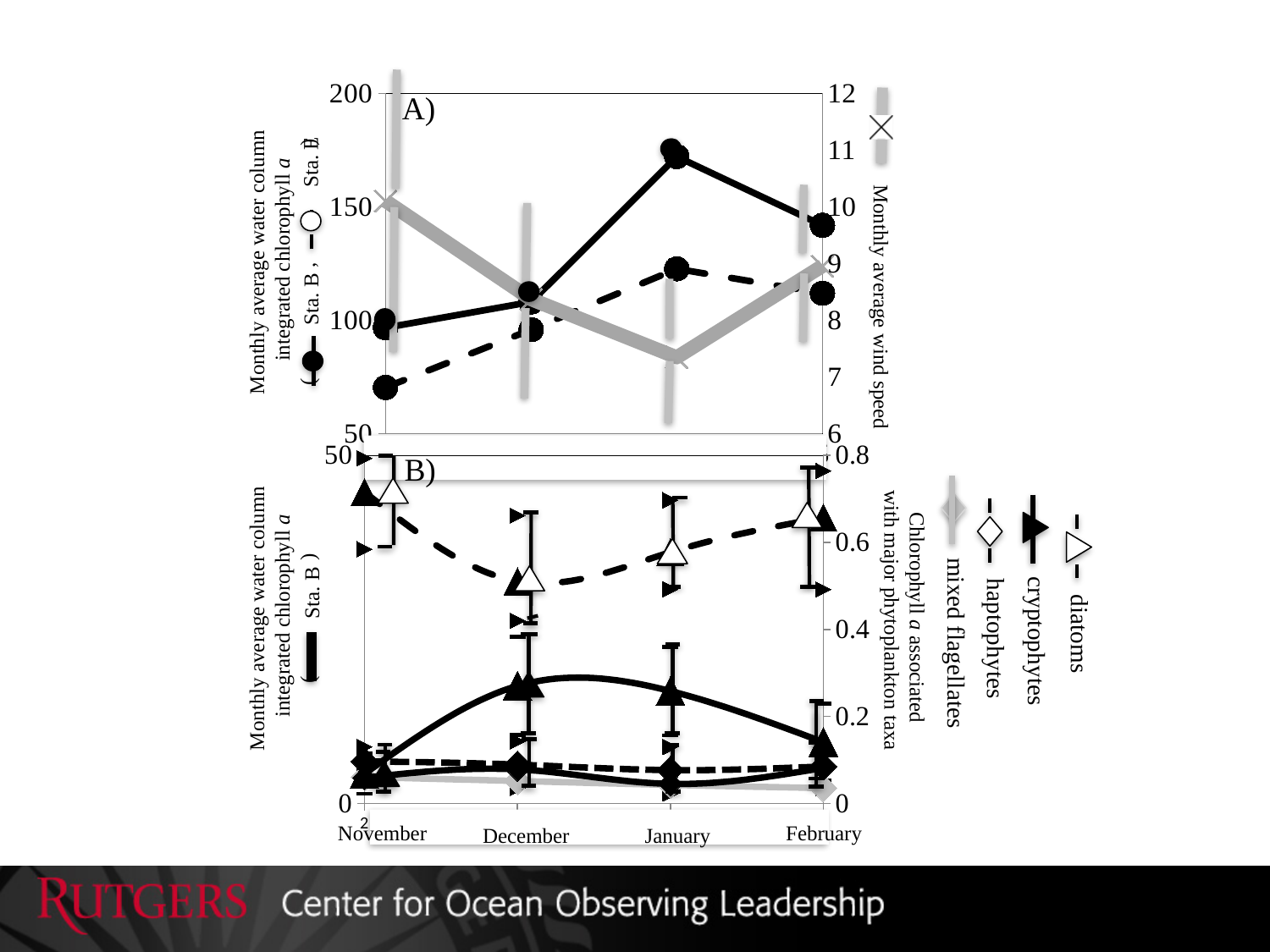
In chart A), is the Sta. B integrated chlorophyll a (solid line) in January greater or less than 150? greater In chart B), which month has the lowest value for diatoms? December How many phytoplankton taxa does the legend of chart B) list? 4 In chart B), which is larger in January: diatoms or cryptophytes? diatoms What kind of chart is chart A)? line chart In chart A), which month has the lowest monthly average wind speed? January In chart A), does the monthly average wind speed rise or fall from November to January? fall In chart A), is the monthly average wind speed in January greater or less than 8? less How many months are shown along the x axis of chart B)? 4 What is the label of the right-hand y axis of chart A)? Monthly average wind speed In chart A), which month has the highest monthly average wind speed? November In chart B), is the value for cryptophytes in December greater or less than 0.2? greater